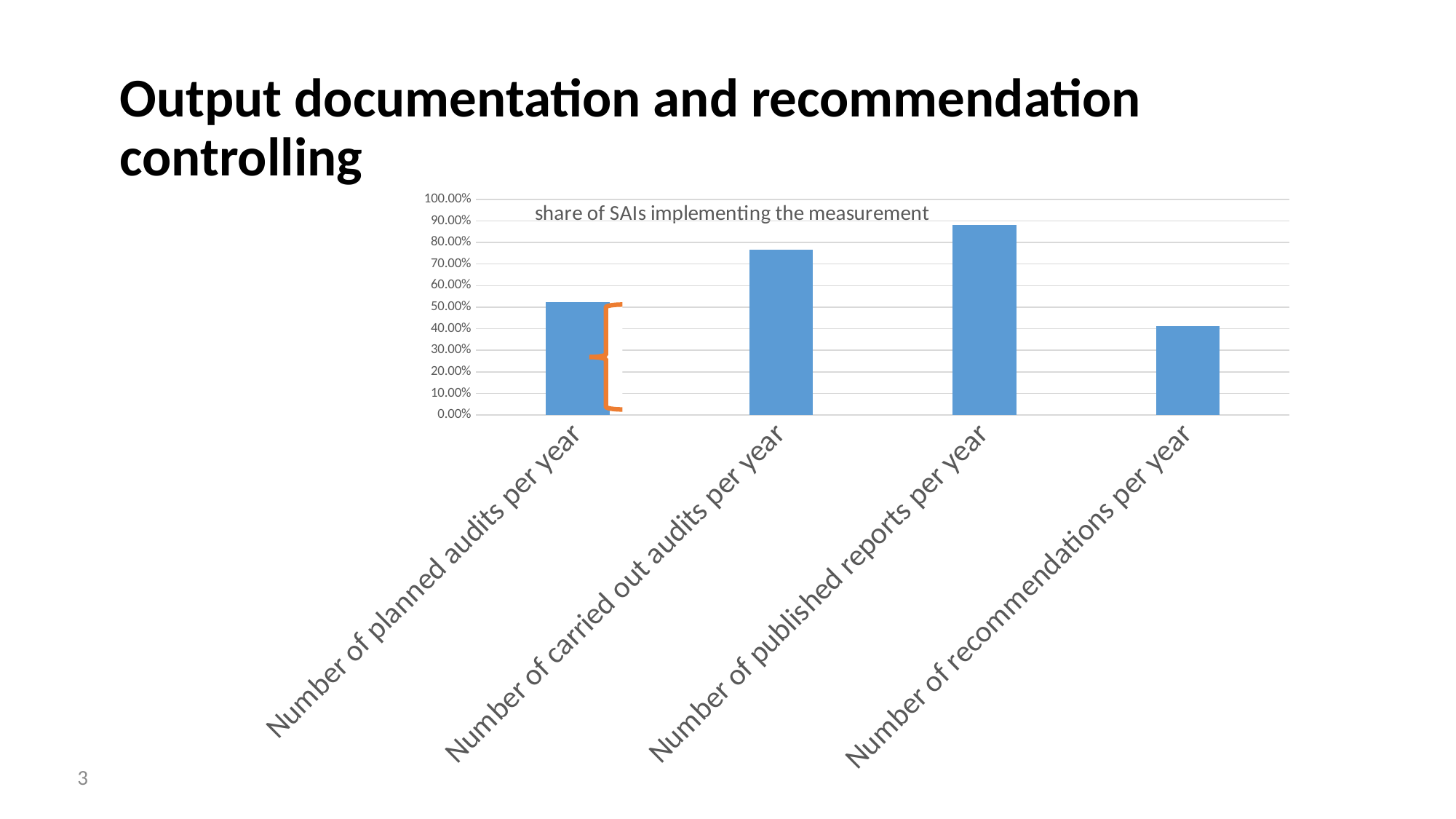
Is the value for Number of planned audits per year greater or less than 60.00%? less Is the value for Number of carried out audits per year greater or less than 70.00%? greater Which is larger: the value for Number of published reports per year or the value for Number of carried out audits per year? Number of published reports per year Which category has the highest share of SAIs implementing the measurement? Number of published reports per year What colour are the bars in the chart? blue Is the value for Number of recommendations per year greater or less than 50.00%? less Which is larger: the value for Number of carried out audits per year or the value for Number of planned audits per year? Number of carried out audits per year How many categories are plotted in the chart? 4 Which category has the lowest share of SAIs implementing the measurement? Number of recommendations per year What is the title of the chart? share of SAIs implementing the measurement What kind of chart is shown on the slide? bar chart